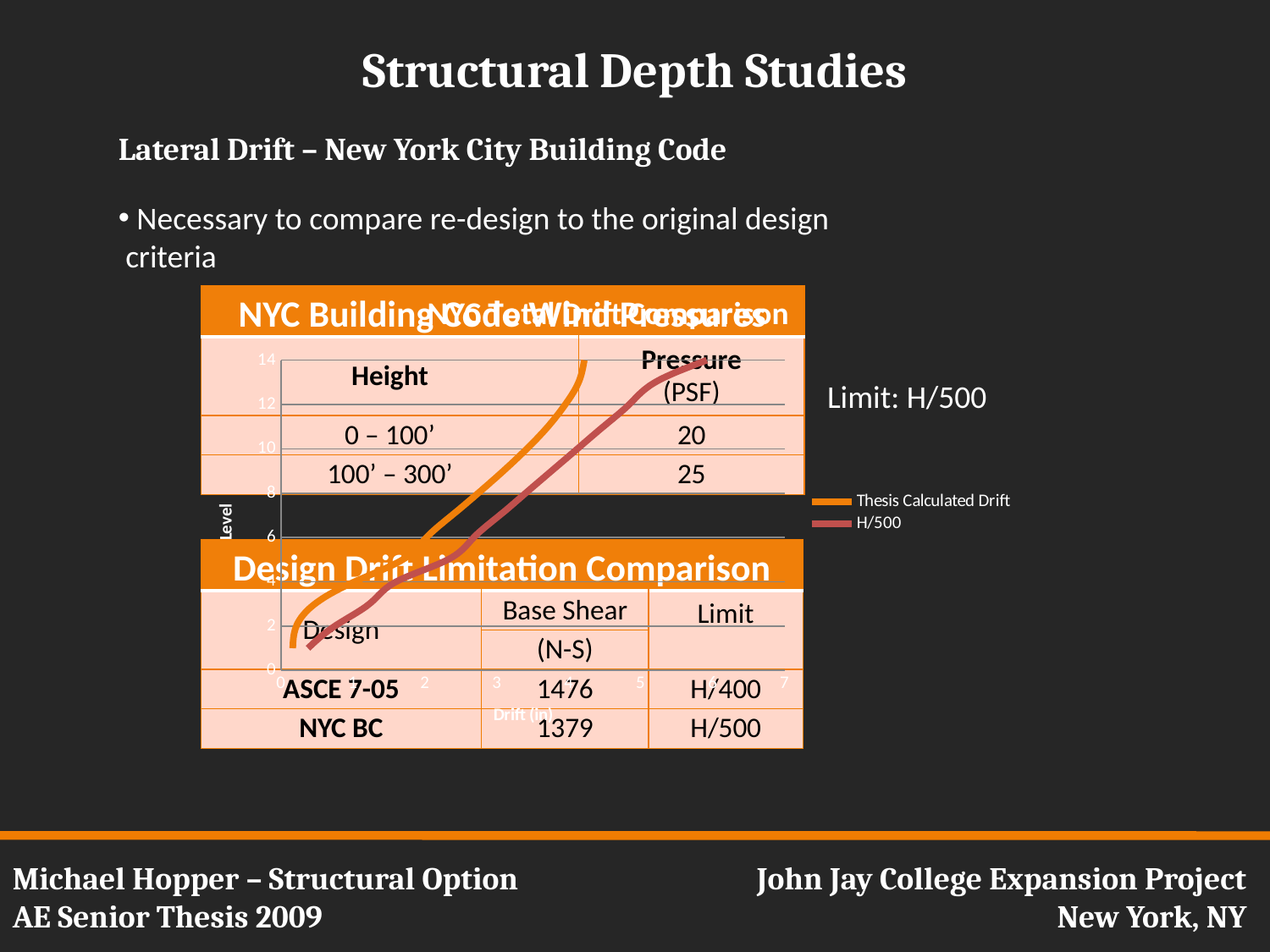
Does the level rise or fall as drift increases along the horizontal axis for both series? rise Is the Thesis Calculated Drift at level 14 greater or less than 6 inches? less What are the two series named in the chart legend? Thesis Calculated Drift and H/500 What is the highest value shown on the chart's horizontal axis (Drift (in))? 7 What kind of chart is shown on the slide? line chart At level 10, which series shows the smaller drift, Thesis Calculated Drift or H/500? Thesis Calculated Drift What is the label of the chart's vertical axis? Level Which series is drawn in orange on the chart? Thesis Calculated Drift How many series does the chart legend list? 2 At level 12, which series shows the greater drift, Thesis Calculated Drift or H/500? H/500 What is the highest value shown on the chart's vertical axis? 14